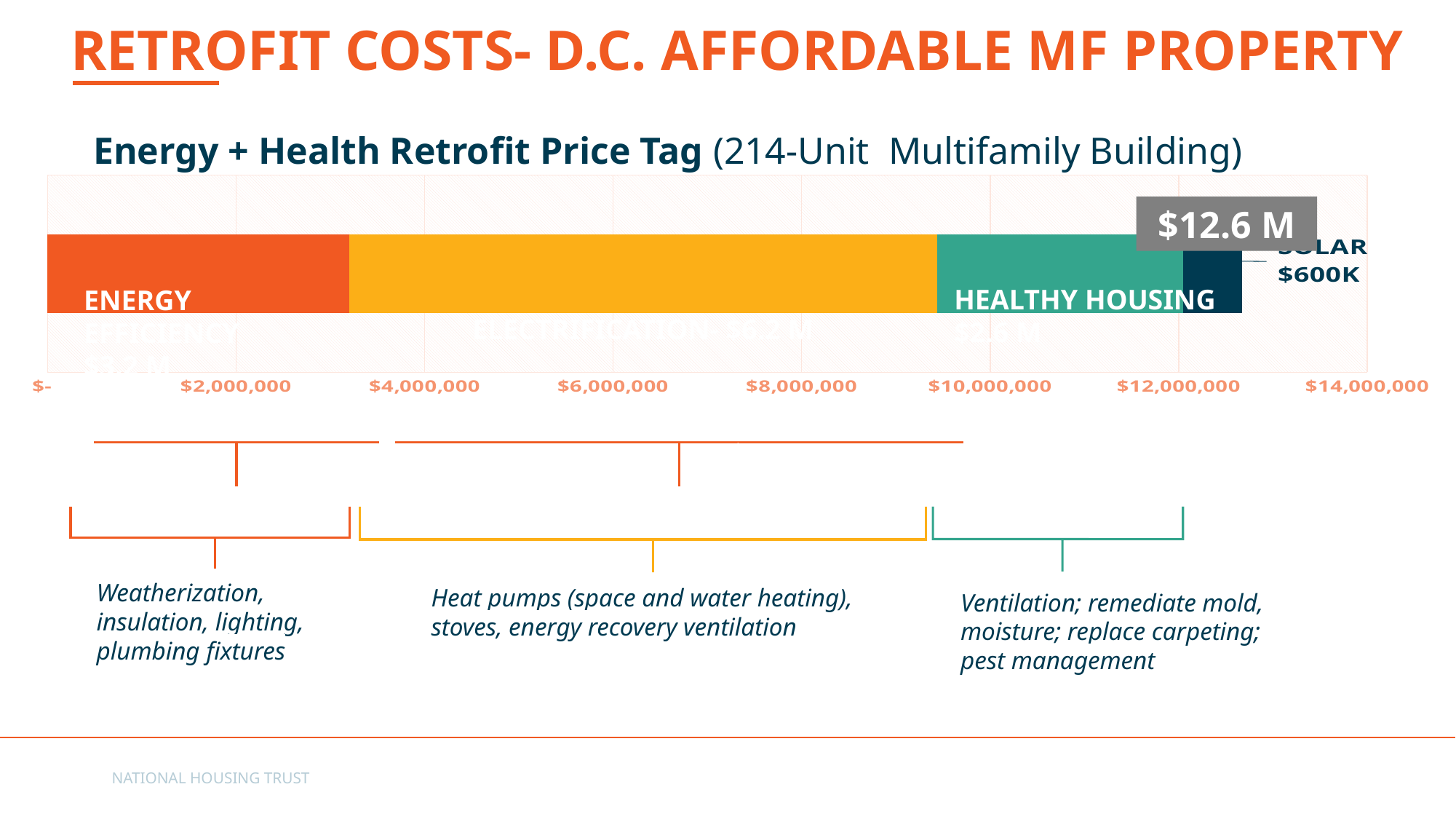
What kind of chart is shown on the slide? Stacked bar chart What is the difference between the Electrification and Healthy Housing segments? $3.7 M What is the value of the Electrification segment? $6.2 M What is the value of the Healthy Housing segment? $2.5 M Which is larger, the Electrification segment or the Healthy Housing segment? Electrification What is the total retrofit cost shown at the end of the stacked bar? $12.6 M Which segment of the bar is the largest? Electrification What is the highest value shown on the horizontal axis? $14,000,000 What is the value of the Solar segment? $600K Is the Energy Efficiency segment greater or less than $4,000,000? less How many segments make up the stacked bar? 4 Which segment of the bar is the smallest? Solar